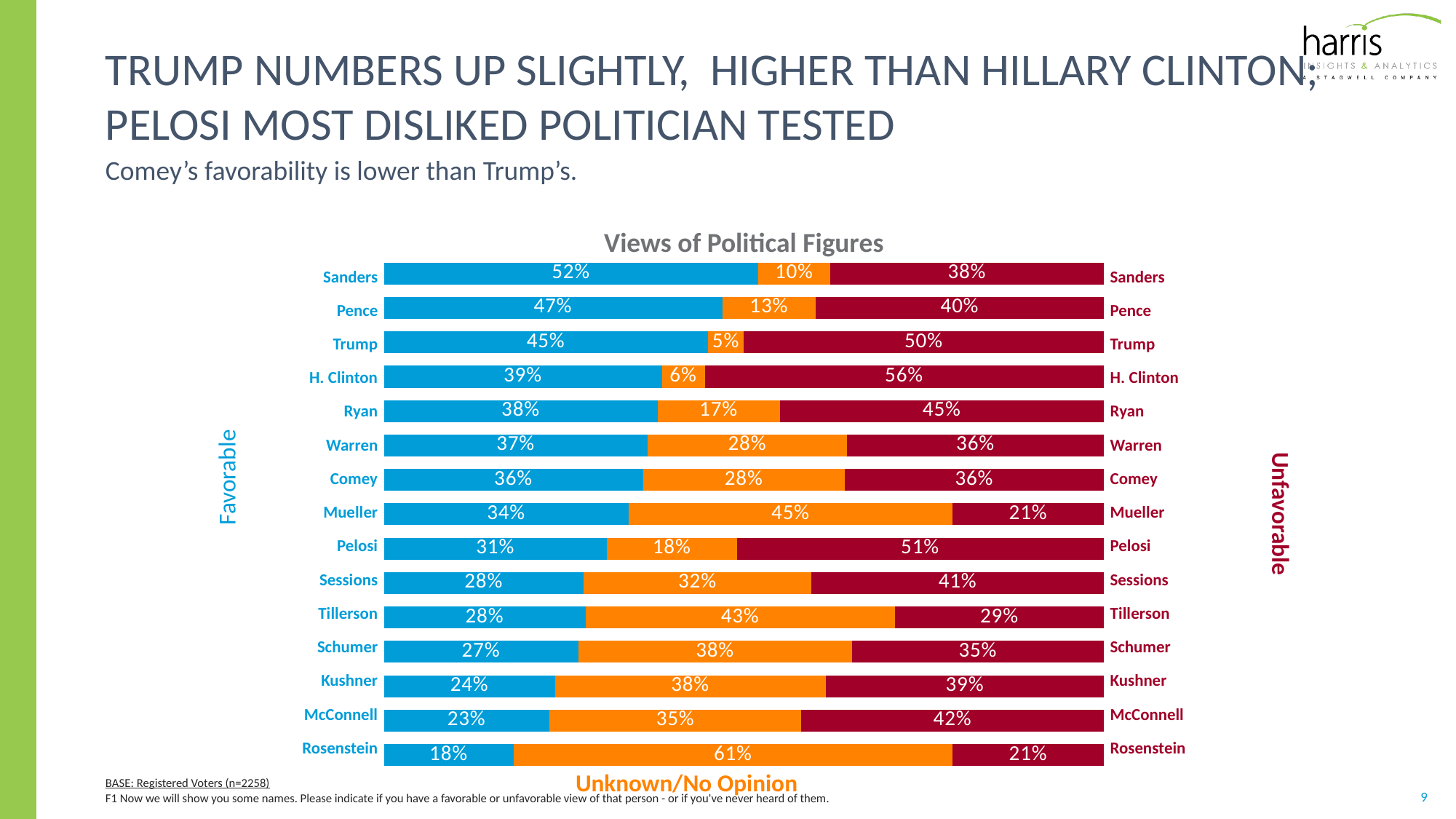
Which political figure has the lowest favorable percentage? Rosenstein Which political figure has the highest unfavorable percentage? H. Clinton How many series (response categories) does the chart show? 3 What is the unfavorable percentage for Trump? 50% What is the difference between Trump's favorable percentage and H. Clinton's favorable percentage? 6% Which political figure has the highest favorable percentage? Sanders What is the Unknown/No Opinion percentage for Rosenstein? 61% Which political figure has the lowest Unknown/No Opinion percentage? Trump Who has the larger unfavorable percentage, Pelosi or Trump? Pelosi How many political figures are shown in the chart? 15 What is the favorable percentage for Sanders? 52% What type of chart is used to show the views of political figures? Stacked bar chart